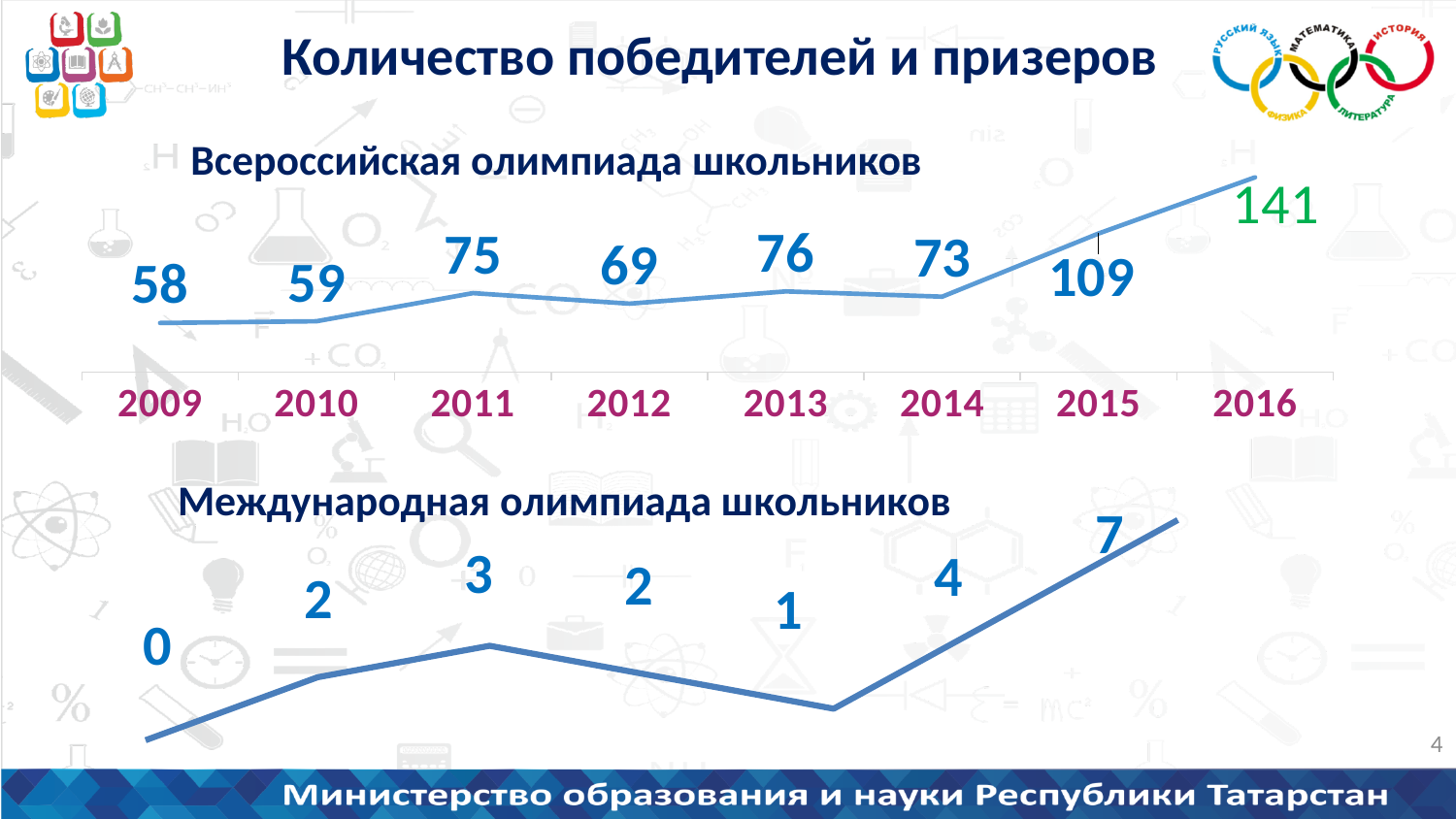
On the chart titled 'Всероссийская олимпиада школьников', what is the difference between the values for 2016 and 2015? 32 On the chart titled 'Всероссийская олимпиада школьников', what is the value for 2016? 141 What kind of chart is the chart titled 'Всероссийская олимпиада школьников'? line chart On the chart titled 'Всероссийская олимпиада школьников', which year has the highest value? 2016 On the chart titled 'Всероссийская олимпиада школьников', what is the value for 2011? 75 On the chart titled 'Международная олимпиада школьников', what is the value of the first point? 0 On the chart titled 'Всероссийская олимпиада школьников', which year has the lowest value? 2009 On the chart titled 'Международная олимпиада школьников', what is the value of the last point? 7 On the chart titled 'Всероссийская олимпиада школьников', which is larger, the value for 2013 or the value for 2014? 2013 On the chart titled 'Международная олимпиада школьников', what is the difference between the highest value and the lowest value? 7 On the chart titled 'Международная олимпиада школьников', how many data points are plotted? 7 On the chart titled 'Всероссийская олимпиада школьников', how many years are plotted? 8